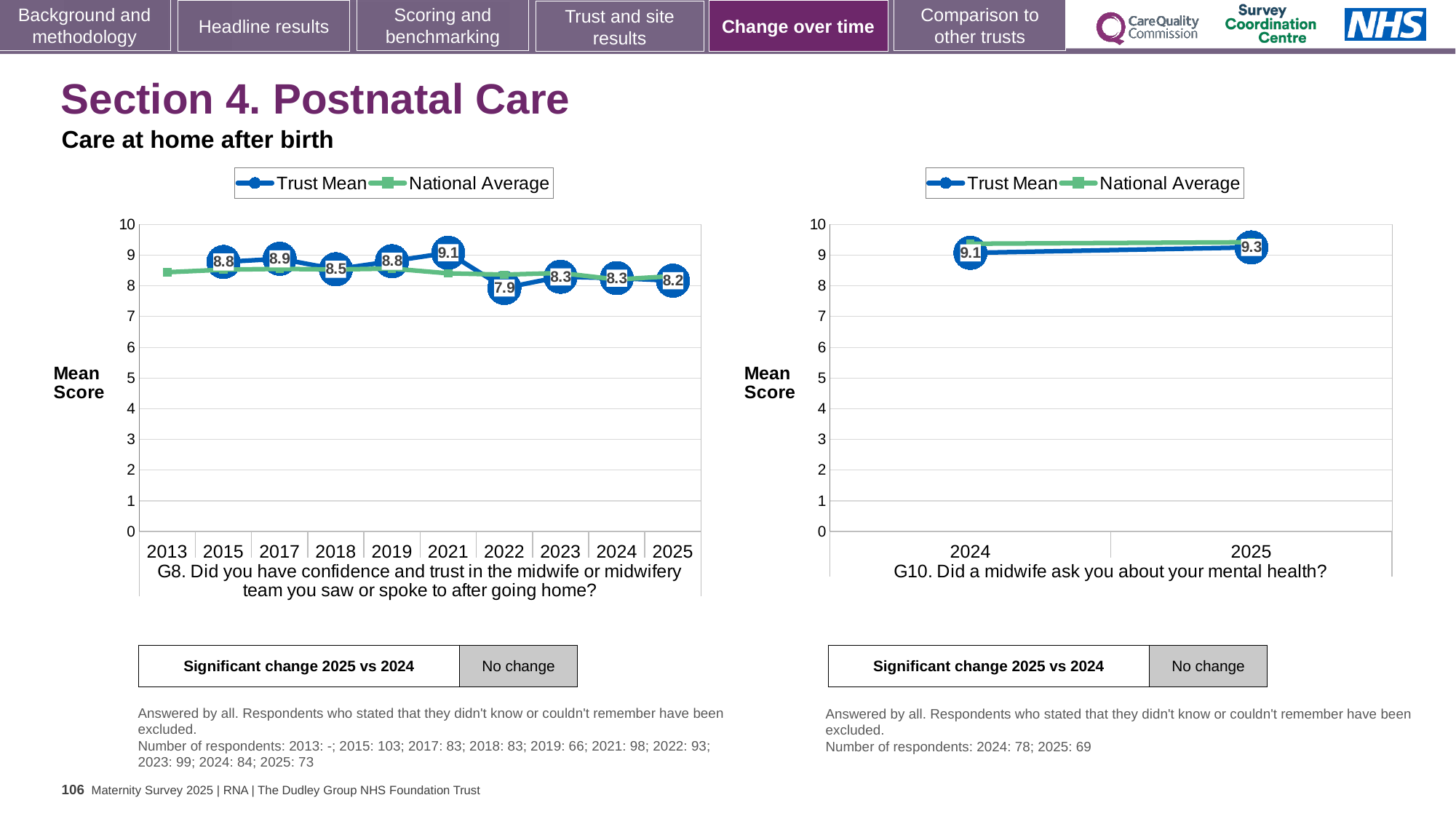
In the G10 chart on the right, what is the Trust Mean score for 2025? 9.3 In the G8 chart on the left, what is the Trust Mean score for 2021? 9.1 In the G8 chart on the left, which year has the lowest Trust Mean score? 2022 In the G8 chart on the left, what is the difference between the Trust Mean scores for 2021 and 2022? 1.2 In the G8 chart on the left, is the Trust Mean score higher in 2017 or in 2018? 2017 What kind of chart is the G8 chart on the left? line chart In the G10 chart on the right, does the Trust Mean rise or fall from 2024 to 2025? rise In the G8 chart on the left, is the National Average for 2013 greater or less than 8? greater How many years are shown on the x axis of the G8 chart on the left? 10 In the G8 chart on the left, which year has the highest Trust Mean score? 2021 How many series does the legend of the G10 chart on the right list? 2 In the G8 chart on the left, what is the Trust Mean score for 2022? 7.9